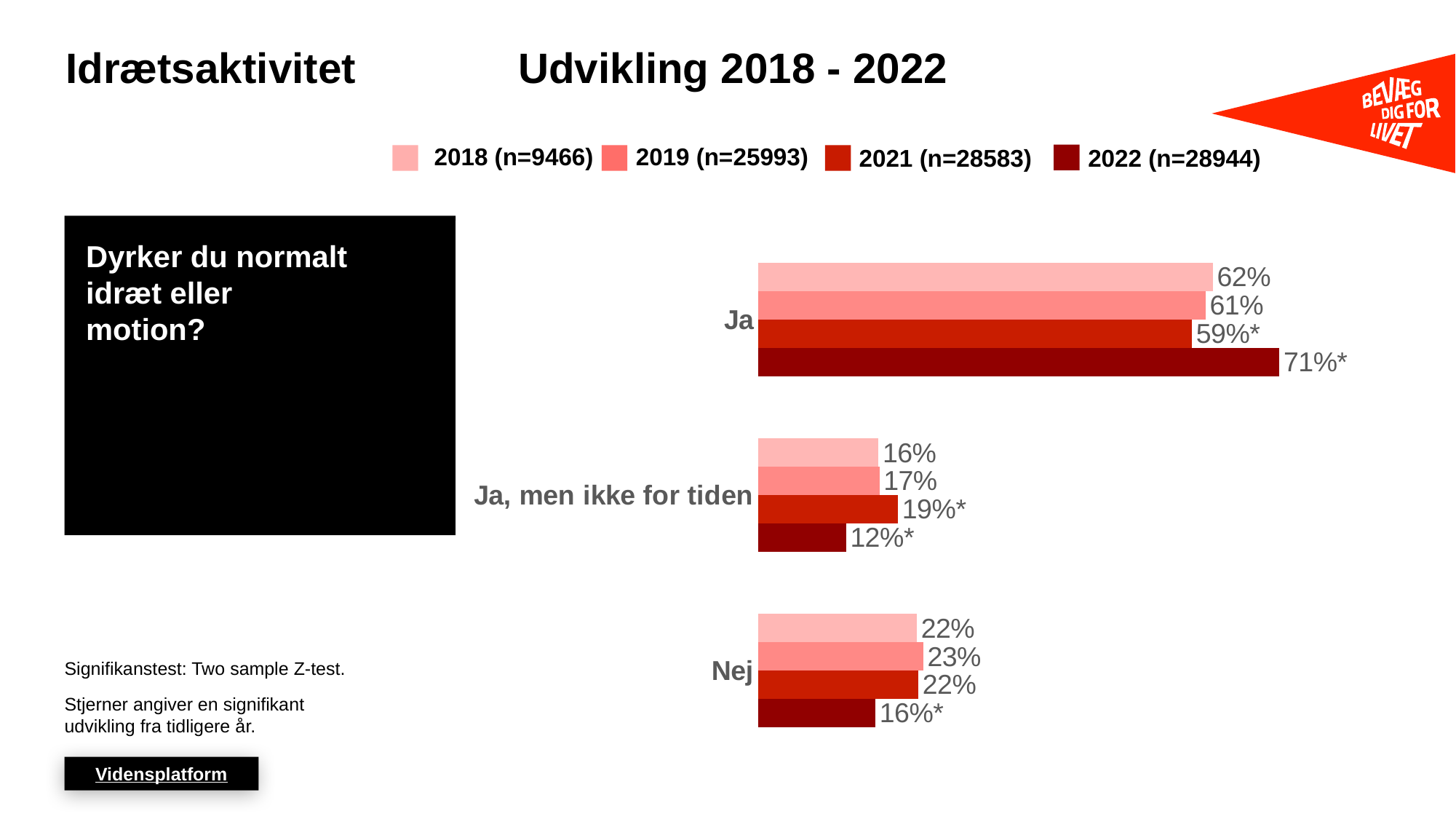
Which is larger for "Nej": the 2019 value or the 2022 value? 2019 What is the value for "Ja" in the 2022 (n=28944) series? 71%* What question is the chart about, as shown in the black box on the left? Dyrker du normalt idræt eller motion? What is the value for "Ja" in the 2018 (n=9466) series? 62% Which category has the highest value in the 2022 (n=28944) series? Ja What kind of chart is shown on the slide? Bar chart What is the difference between the 2022 and 2021 values for "Ja"? 12 percentage points What is the value for "Nej" in the 2019 (n=25993) series? 23% What is the value for "Ja, men ikke for tiden" in the 2021 (n=28583) series? 19%* How many categories are shown on the chart? 3 Which category has the lowest value in the 2018 (n=9466) series? Ja, men ikke for tiden How many series does the legend list? 4